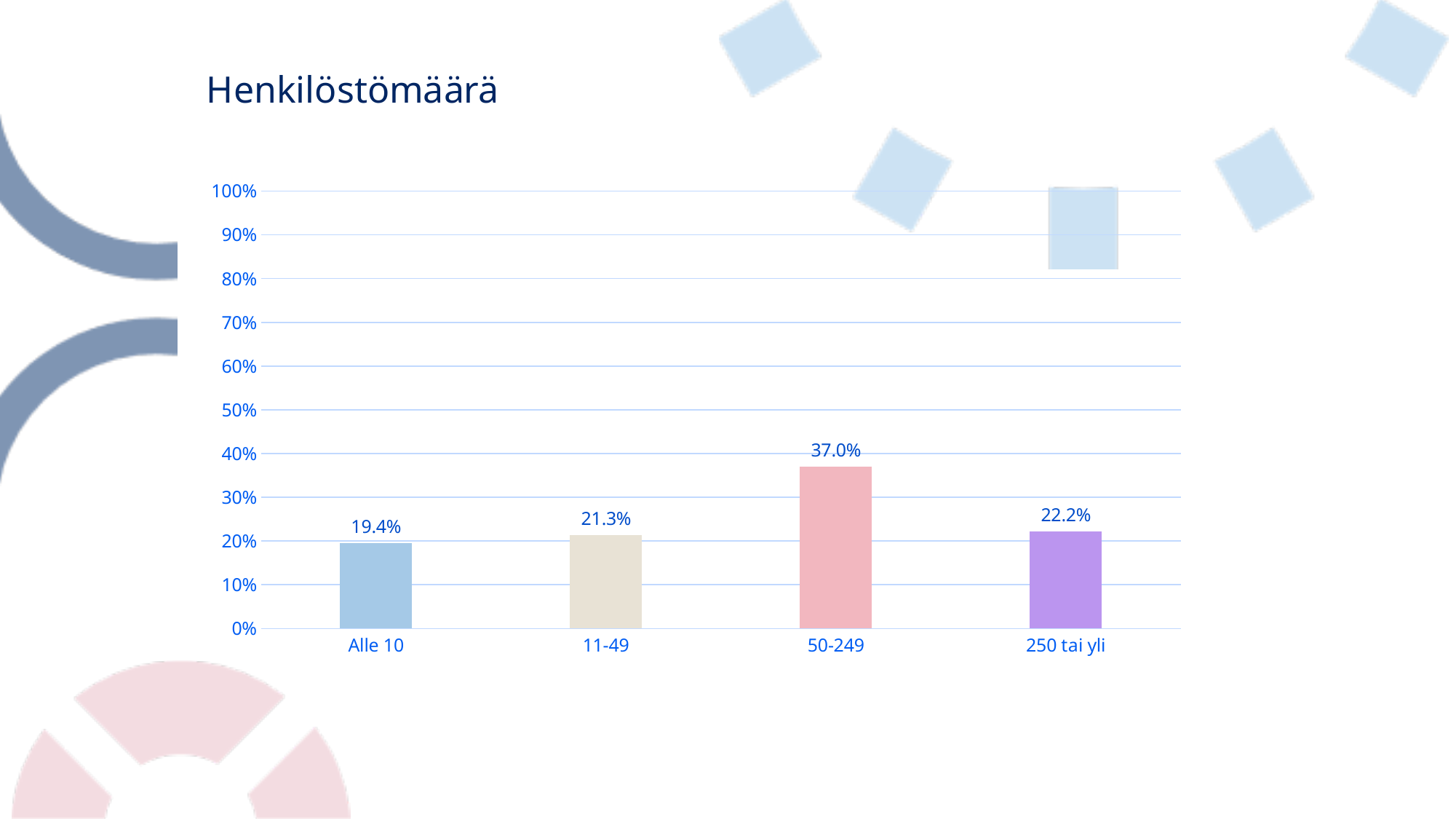
What kind of chart is shown on the slide? bar chart Which category has the lowest value? Alle 10 Which is larger, the value for '11-49' or the value for '250 tai yli'? 250 tai yli What is the value for the 'Alle 10' category? 19.4% What is the value for the '11-49' category? 21.3% What is the title of the slide? Henkilöstömäärä What is the value for the '250 tai yli' category? 22.2% What is the difference between the values for '50-249' and 'Alle 10'? 17.6% Which category has the highest value? 50-249 What is the value for the '50-249' category? 37.0% How many categories are shown on the x axis? 4 Is the value for '50-249' greater or less than 30%? greater